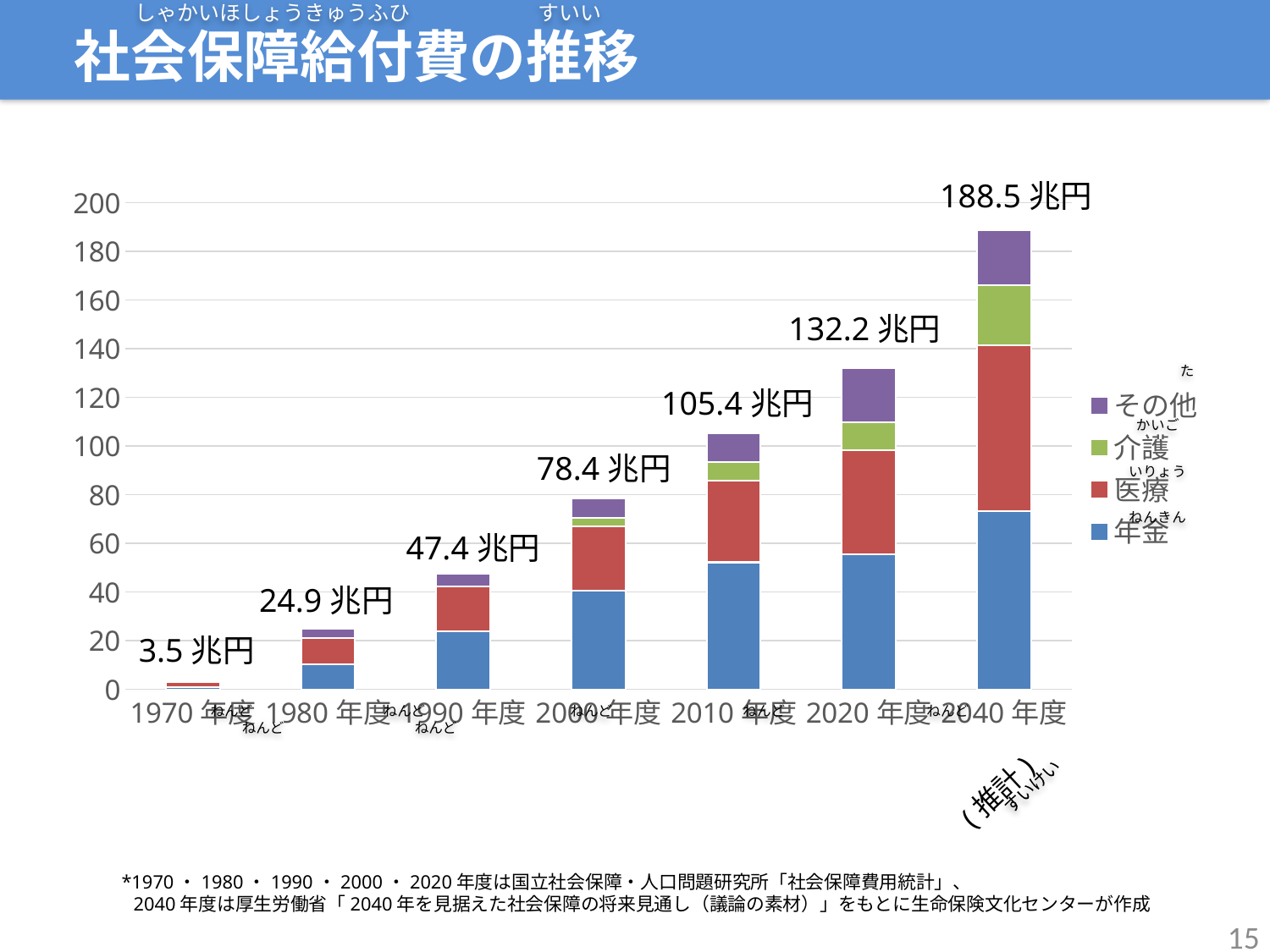
What is the difference between the total for 2010年度 and the total for 2000年度? 27兆円 How many series does the legend list? 4 Which is larger, the total for 1980年度 or the total for 1990年度? 1990年度 What is the total social security benefit expenditure shown for 2040年度? 188.5兆円 Which fiscal year has the highest total social security benefit expenditure? 2040年度 What is the difference between the total for 2040年度 and the total for 2020年度? 56.3兆円 How many fiscal years are shown on the x axis? 7 Is the 年金 value for 2040年度 greater or less than 60? greater What is the total value labeled for 1990年度? 47.4兆円 What kind of chart is shown on the slide? Stacked bar chart Which fiscal year has the lowest total social security benefit expenditure? 1970年度 What is the total value labeled for 2000年度? 78.4兆円